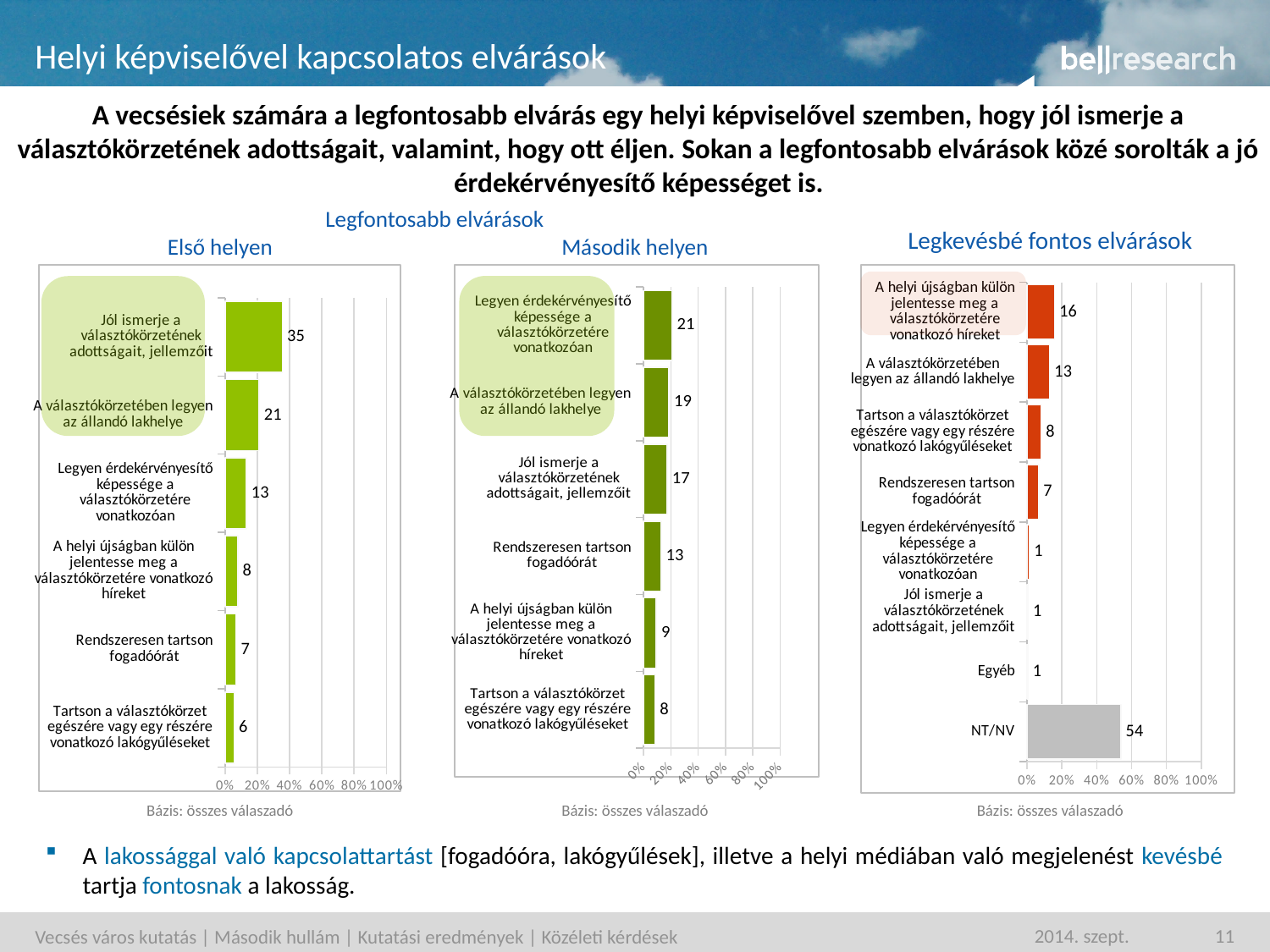
In the 'Legkevésbé fontos elvárások' chart, how many categories are shown? 8 What type of chart is the 'Első helyen' chart? Bar chart In the 'Legkevésbé fontos elvárások' chart, which is larger: 'A helyi újságban külön jelentesse meg a választókörzetére vonatkozó híreket' or 'A választókörzetében legyen az állandó lakhelye'? A helyi újságban külön jelentesse meg a választókörzetére vonatkozó híreket In the 'Legkevésbé fontos elvárások' chart, what is the value for 'NT/NV'? 54 In the 'Első helyen' chart, what is the value for 'Jól ismerje a választókörzetének adottságait, jellemzőit'? 35 In the 'Első helyen' chart, which category has the lowest value? Tartson a választókörzet egészére vagy egy részére vonatkozó lakógyűléseket In the 'Első helyen' chart, what is the value for 'Rendszeresen tartson fogadóórát'? 7 In the 'Második helyen' chart, which category has the highest value? Legyen érdekérvényesítő képessége a választókörzetére vonatkozóan In the 'Második helyen' chart, what is the value for 'Rendszeresen tartson fogadóórát'? 13 In the 'Legkevésbé fontos elvárások' chart, is the value for 'NT/NV' greater or less than 40%? greater In the 'Első helyen' chart, what is the difference between 'Jól ismerje a választókörzetének adottságait, jellemzőit' and 'A választókörzetében legyen az állandó lakhelye'? 14 In the 'Második helyen' chart, how many categories are shown? 6